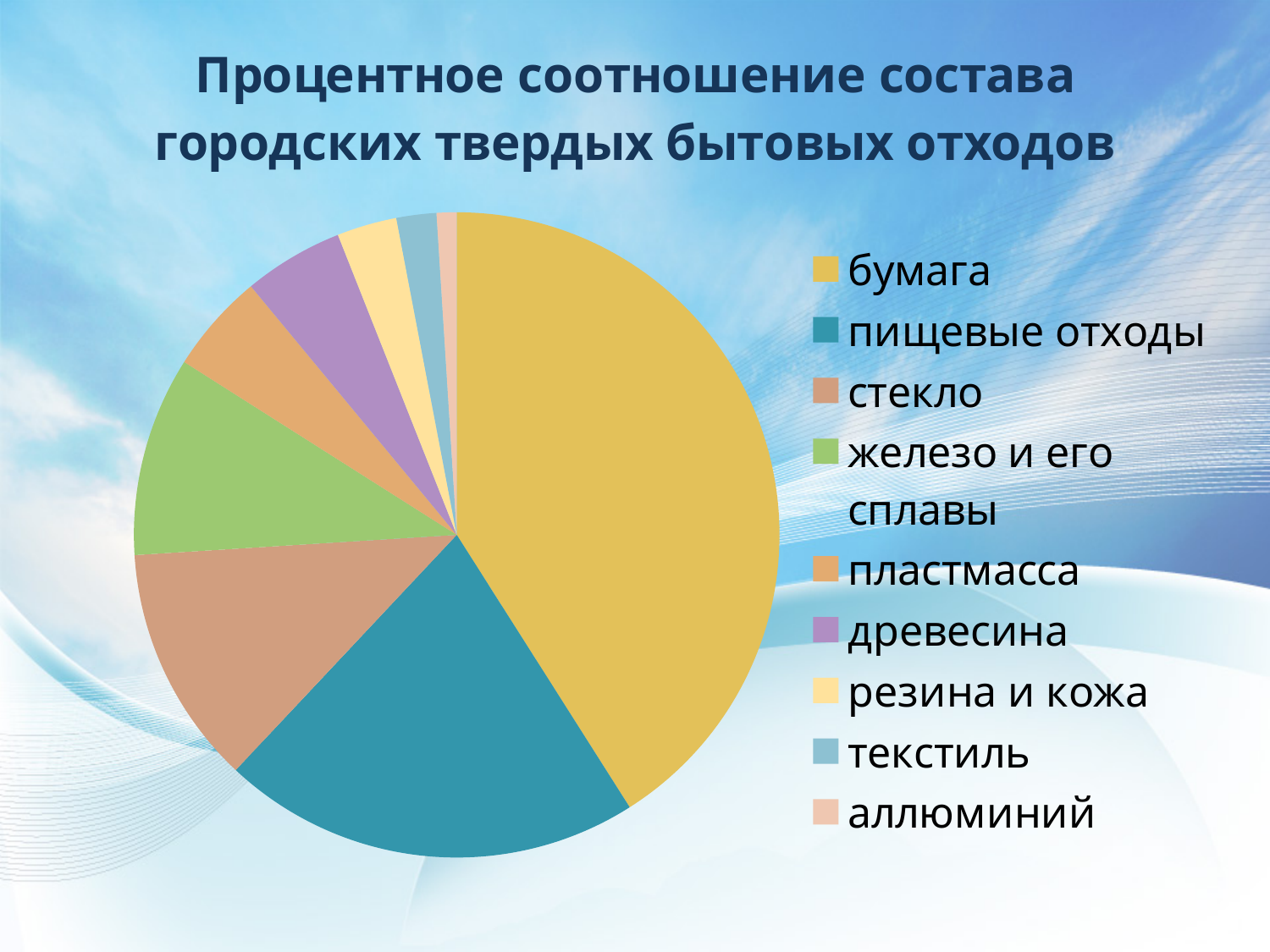
Which category is the second largest slice of the pie? пищевые отходы What is the title of the chart? Процентное соотношение состава городских твердых бытовых отходов What kind of chart is shown on the slide? pie chart Which category has the smallest slice of the pie? аллюминий Which slice is larger, бумага or пищевые отходы? бумага Which slice is larger, железо и его сплавы or текстиль? железо и его сплавы Which slice is larger, стекло or железо и его сплавы? стекло How many categories does the pie chart have? 9 Which category has the largest slice of the pie? бумага What colour is the slice for бумага? yellow